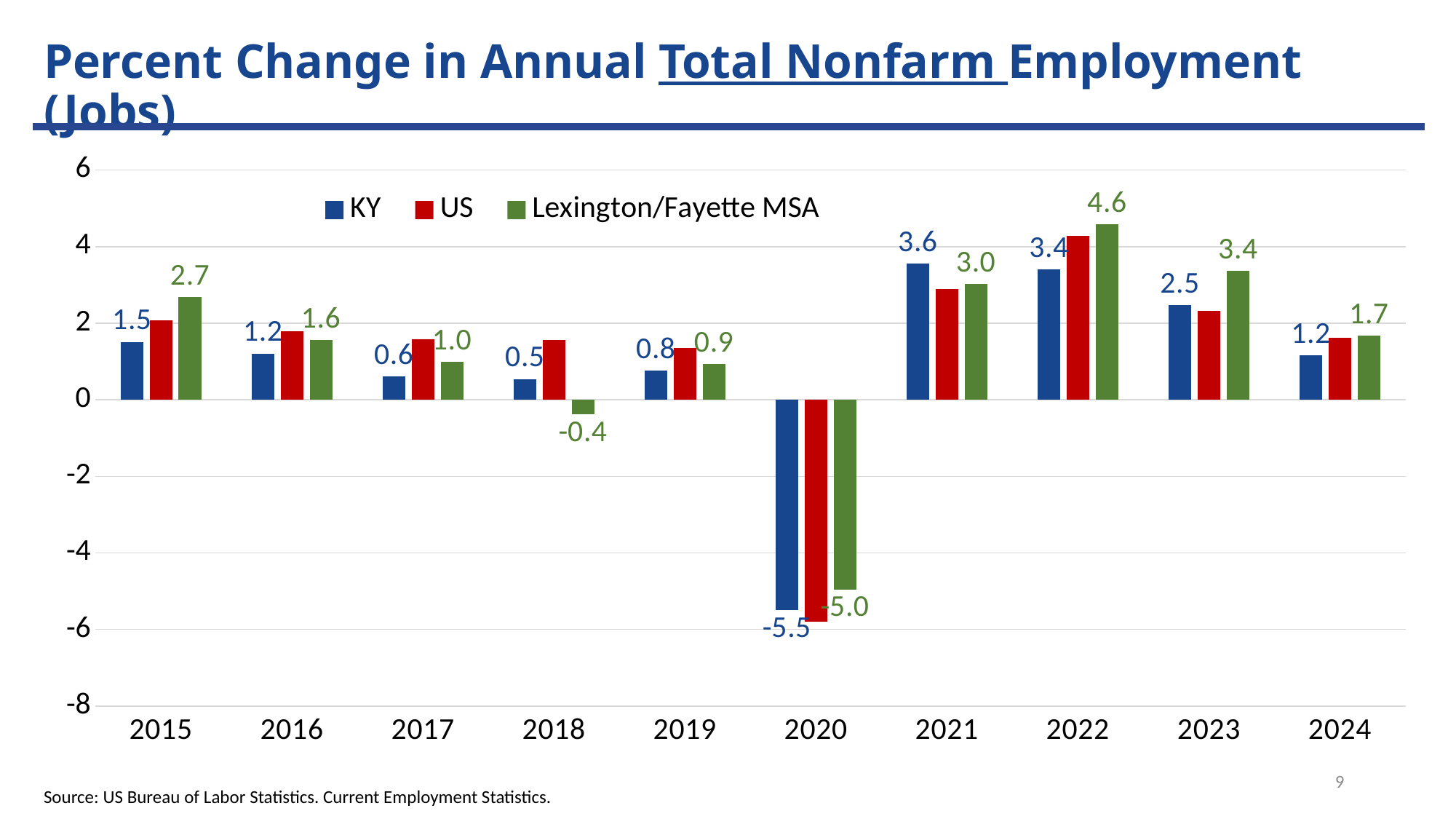
How many years are shown on the x axis? 10 What kind of chart is shown on the slide? bar chart In which year is the KY value lowest? 2020 What colour represents the US series in the legend? red In 2015, which is larger: the KY value or the Lexington/Fayette MSA value? Lexington/Fayette MSA What is the value for KY in 2021? 3.6 What is the value for Lexington/Fayette MSA in 2018? -0.4 What is the value for Lexington/Fayette MSA in 2022? 4.6 What is the difference between the Lexington/Fayette MSA value and the KY value in 2022? 1.2 In which year is the Lexington/Fayette MSA value highest? 2022 How many series does the legend list? 3 Is the value for US in 2020 greater or less than -4? less